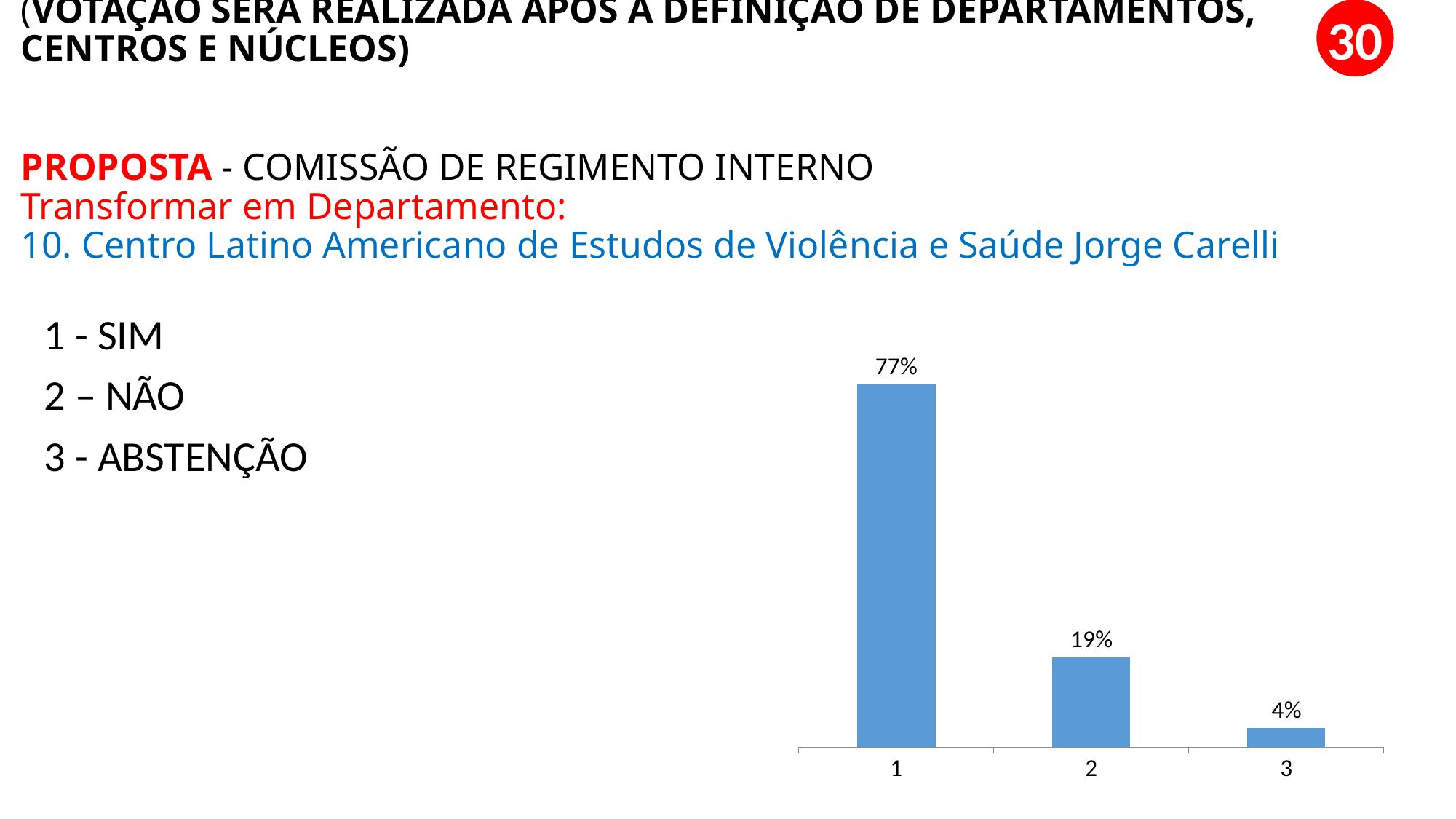
How many categories are shown in the bar chart? 3 What kind of chart is shown on the slide? bar chart According to the slide's legend text, what does category 1 represent? SIM Which category has the lowest value in the bar chart? 3 What is the value for category 3 in the bar chart? 4% What is the difference between the values for category 2 and category 3? 15% Which is larger, the value for category 2 or category 3? 2 What is the value for category 2 in the bar chart? 19% Which category has the highest value in the bar chart? 1 What is the difference between the values for category 1 and category 2? 58% Do the values rise or fall from category 1 to category 3? fall What is the value for category 1 in the bar chart? 77%